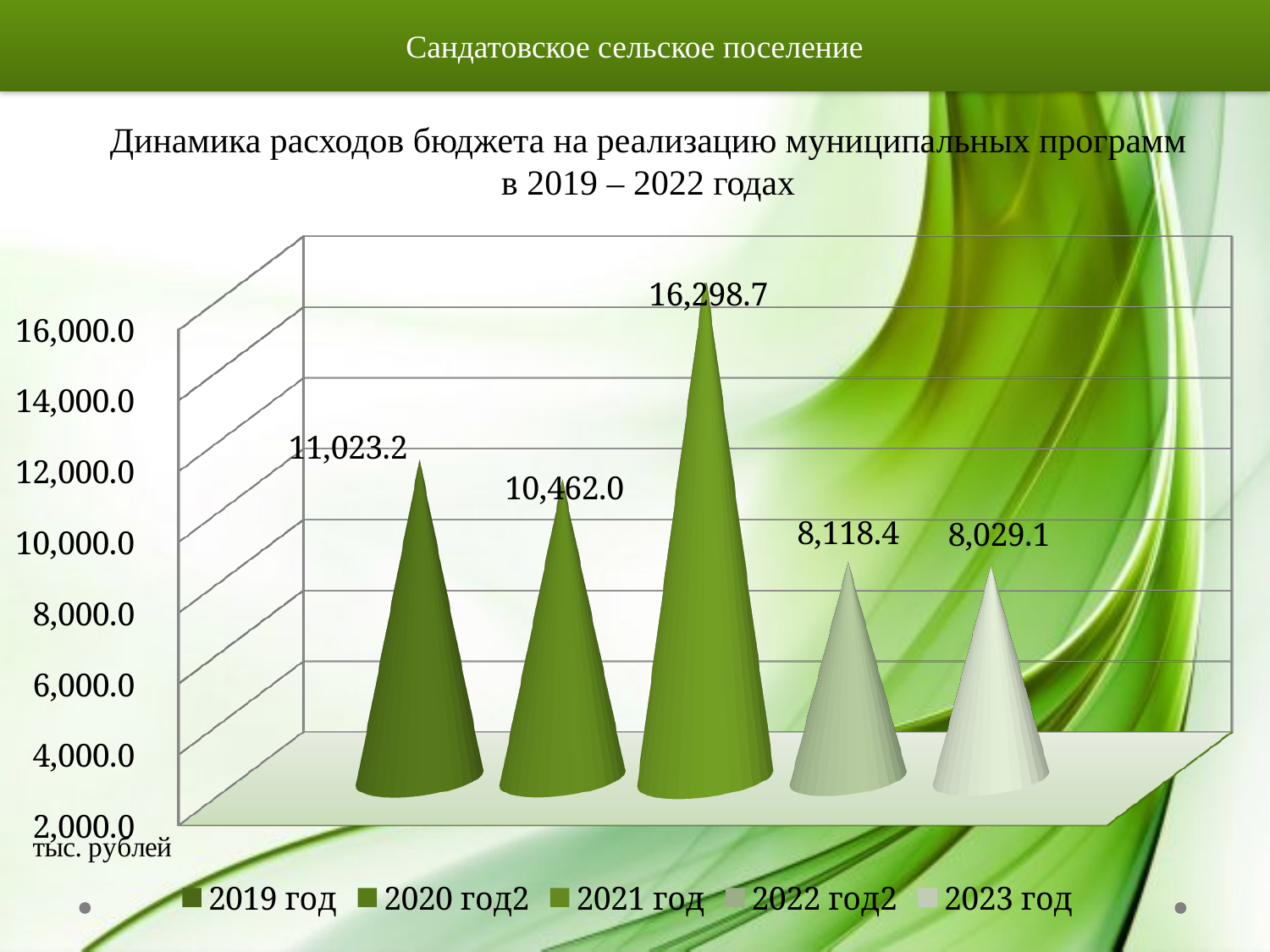
Which year has the lowest value? 2023 год What is the value for 2020 год2? 10,462.0 Which year has the highest value? 2021 год What is the value for 2023 год? 8,029.1 What kind of chart is shown on the slide? bar chart Which is larger, the value for 2019 год or the value for 2020 год2? 2019 год How many series does the legend list? 5 What is the value for 2019 год? 11,023.2 What is the value for 2021 год? 16,298.7 What is the difference between the values for 2021 год and 2019 год? 5,275.5 What unit is indicated below the vertical axis of the chart? тыс. рублей What is the difference between the values for 2022 год2 and 2023 год? 89.3